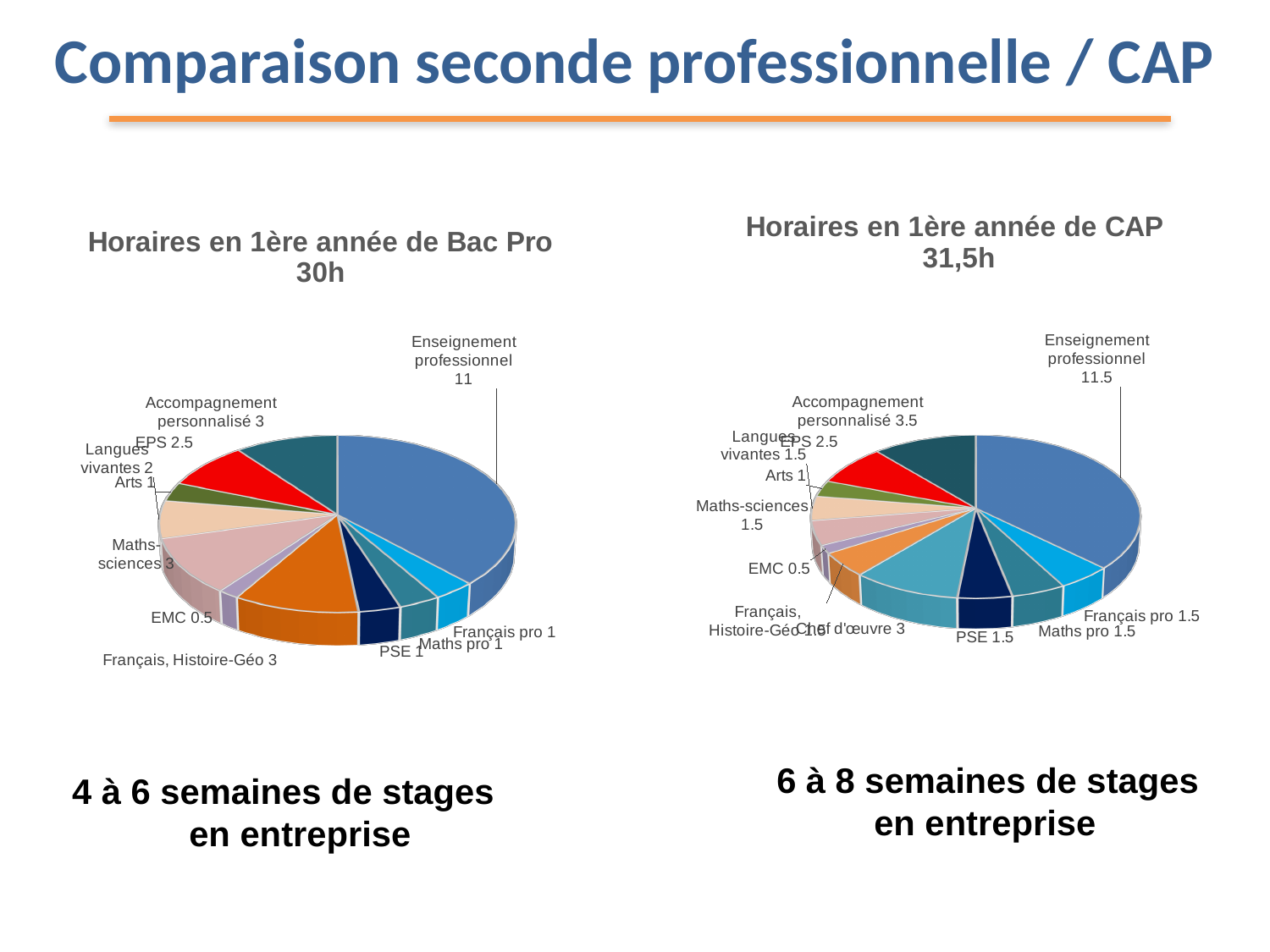
In the 'Horaires en 1ère année de Bac Pro 30h' chart, what is the value for Enseignement professionnel? 11 How many slices does the 'Horaires en 1ère année de Bac Pro 30h' chart have? 11 What type of chart is used on this slide? Pie chart How many slices does the 'Horaires en 1ère année de CAP 31,5h' chart have? 12 In the 'Horaires en 1ère année de Bac Pro 30h' chart, which category has the largest slice? Enseignement professionnel In the 'Horaires en 1ère année de CAP 31,5h' chart, what is the value for Chef d'œuvre? 3 In the 'Horaires en 1ère année de CAP 31,5h' chart, which category has the smallest slice? EMC In the 'Horaires en 1ère année de Bac Pro 30h' chart, what is the value for EMC? 0.5 In the 'Horaires en 1ère année de CAP 31,5h' chart, what is the value for Accompagnement personnalisé? 3.5 What is the title of the chart on the right side of the slide? Horaires en 1ère année de CAP 31,5h What is the difference between Enseignement professionnel in the CAP chart (11.5) and in the Bac Pro chart (11)? 0.5 In the 'Horaires en 1ère année de Bac Pro 30h' chart, which is larger: Maths-sciences or EPS? Maths-sciences